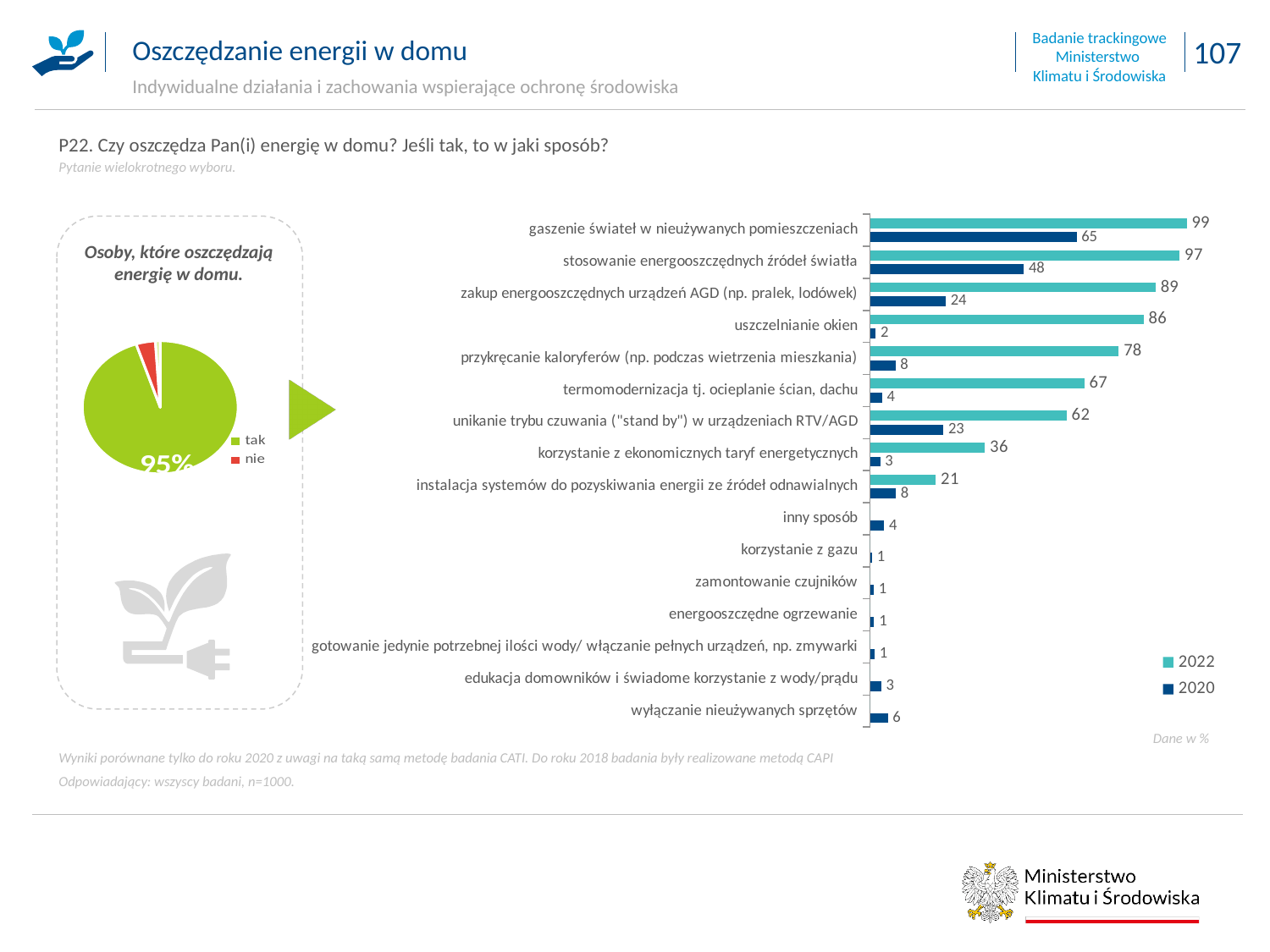
In the bar chart, what is the 2020 value for 'stosowanie energooszczędnych źródeł światła'? 48 How many categories are shown in the bar chart? 16 What kind of chart is the chart on the left side of the slide? pie chart In the bar chart, what is the 2022 value for 'gaszenie świateł w nieużywanych pomieszczeniach'? 99 In the bar chart, what is the difference between the 2022 and 2020 values for 'zakup energooszczędnych urządzeń AGD (np. pralek, lodówek)'? 65 How many series does the legend of the bar chart list? 2 In the bar chart, what is the 2022 value for 'uszczelnianie okien'? 86 In the bar chart, which category has the highest 2022 value? gaszenie świateł w nieużywanych pomieszczeniach In the bar chart, which is larger: the 2022 value for 'unikanie trybu czuwania ("stand by") w urządzeniach RTV/AGD' or the 2022 value for 'korzystanie z ekonomicznych taryf energetycznych'? unikanie trybu czuwania ("stand by") w urządzeniach RTV/AGD In the pie chart on the left, what share is labelled for 'tak'? 95% What kind of chart is the chart on the right side of the slide? bar chart In the bar chart, what is the 2020 value for 'wyłączanie nieużywanych sprzętów'? 6